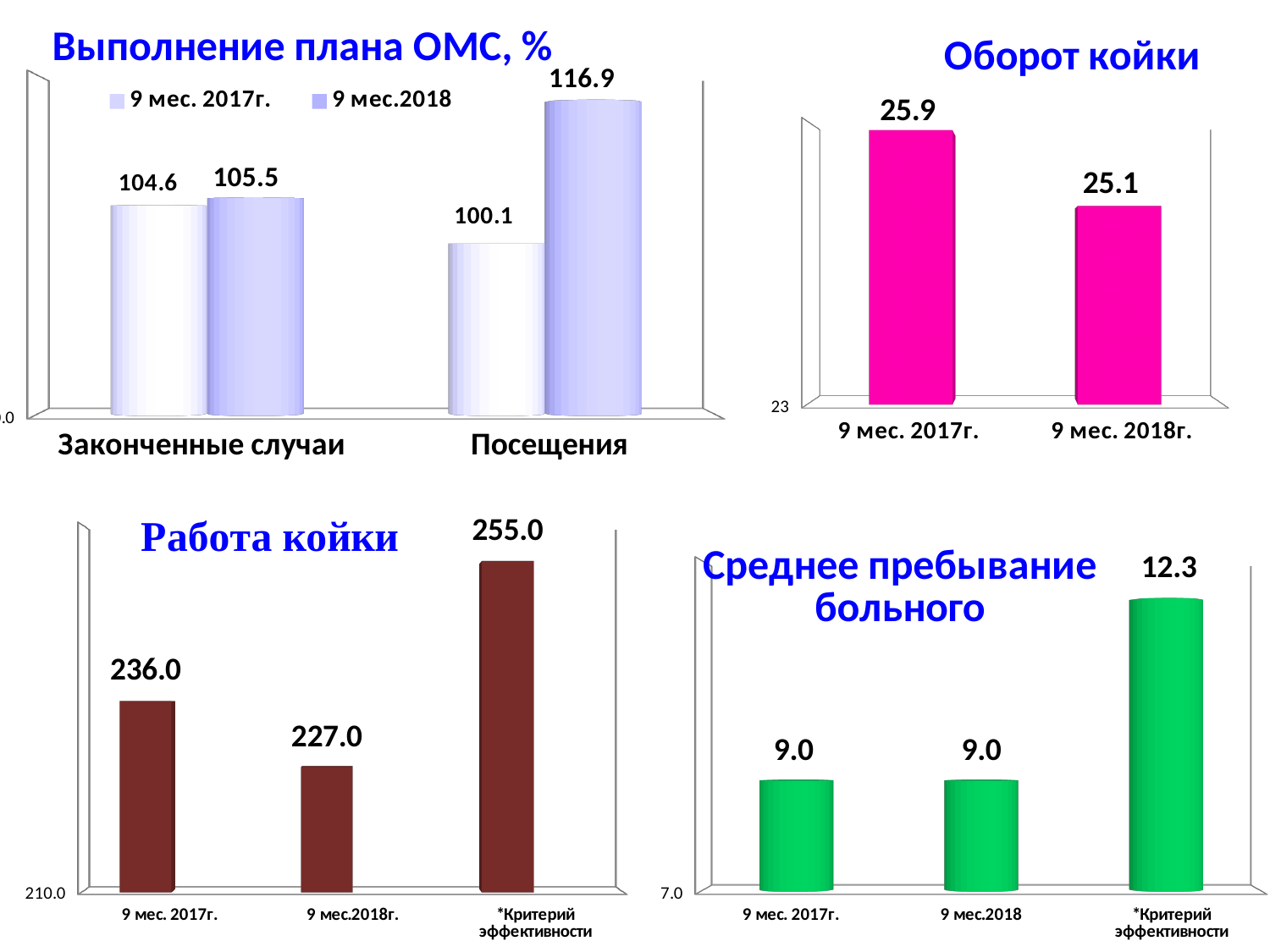
In the chart 'Оборот койки', what is the value for 9 мес. 2018г.? 25.1 In the chart 'Выполнение плана ОМС, %', what is the difference between the 9 мес.2018 and 9 мес. 2017г. values for Посещения? 16.8 In the chart 'Оборот койки', which period has the higher value? 9 мес. 2017г. In the chart 'Выполнение плана ОМС, %', how many series does the legend list? 2 In the chart 'Оборот койки', what is the difference between the 9 мес. 2017г. and 9 мес. 2018г. values? 0.8 In the chart 'Работа койки', what is the value for *Критерий эффективности? 255.0 In the chart 'Выполнение плана ОМС, %', what is the value for Посещения in 9 мес.2018? 116.9 In the chart 'Выполнение плана ОМС, %', what is the value for Законченные случаи in 9 мес. 2017г.? 104.6 In the chart 'Работа койки', which category has the lowest value? 9 мес.2018г. What kind of chart is 'Среднее пребывание больного'? bar chart In the chart 'Среднее пребывание больного', what is the value for *Критерий эффективности? 12.3 In the chart 'Работа койки', how many bars are plotted? 3